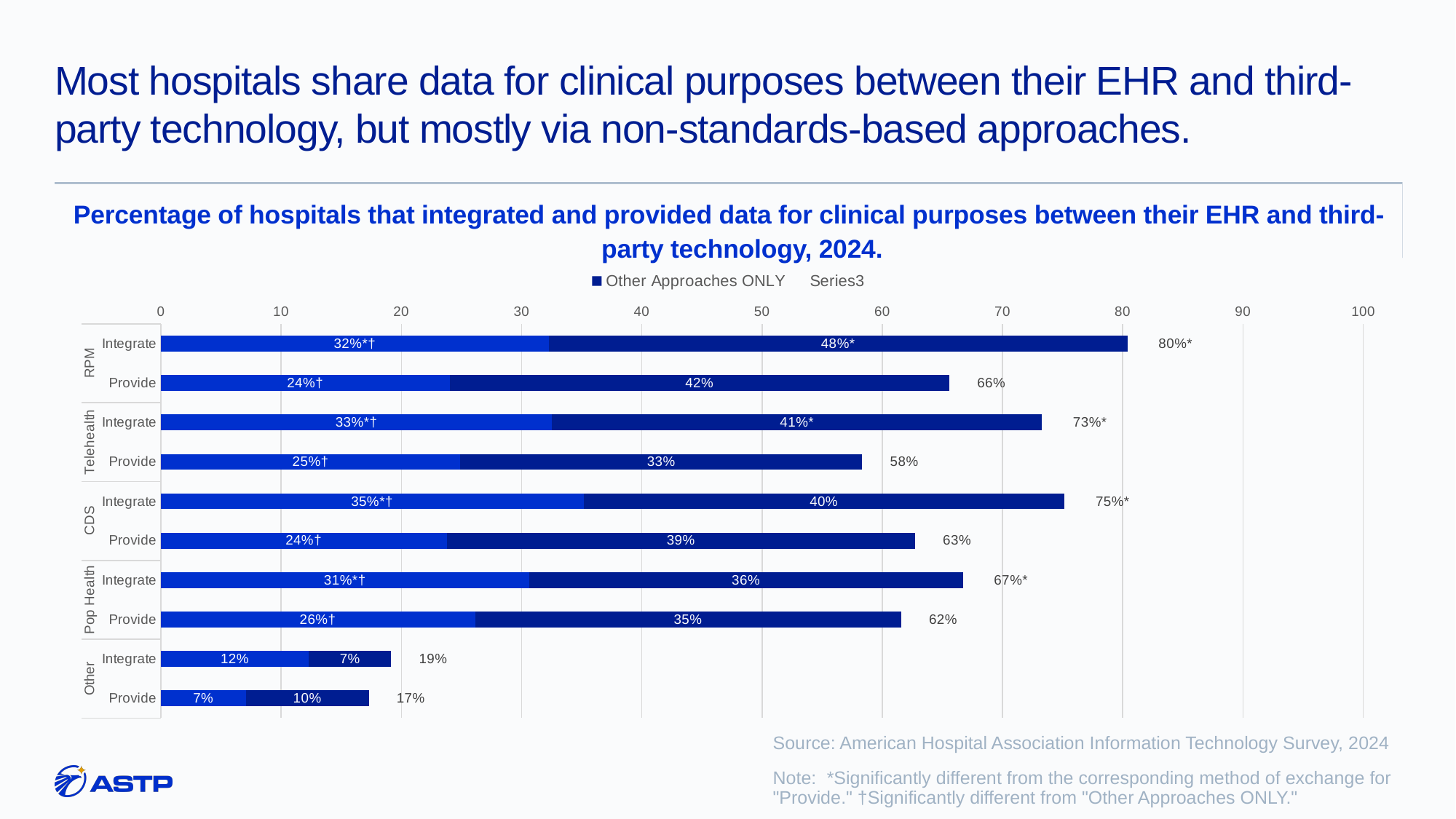
What is the value of the dark blue 'Other Approaches ONLY' segment for the CDS Provide bar? 39% How many bars are plotted in the chart? 10 Which bar has the lowest total percentage? Other Provide What is the total percentage label shown for the Other Provide bar? 17% What kind of chart is shown on the slide? stacked bar chart What is the difference between the total for Pop Health Integrate (67%) and Pop Health Provide (62%)? 5% Which bar has the highest total percentage? RPM Integrate What is the total percentage label shown for the RPM Integrate bar? 80%* Is the total for the Other Integrate bar greater or less than 20? less What is the first entry listed in the chart legend? Other Approaches ONLY Which has a larger total percentage, CDS Integrate or Telehealth Integrate? CDS Integrate What is the total percentage label shown for the Telehealth Provide bar? 58%